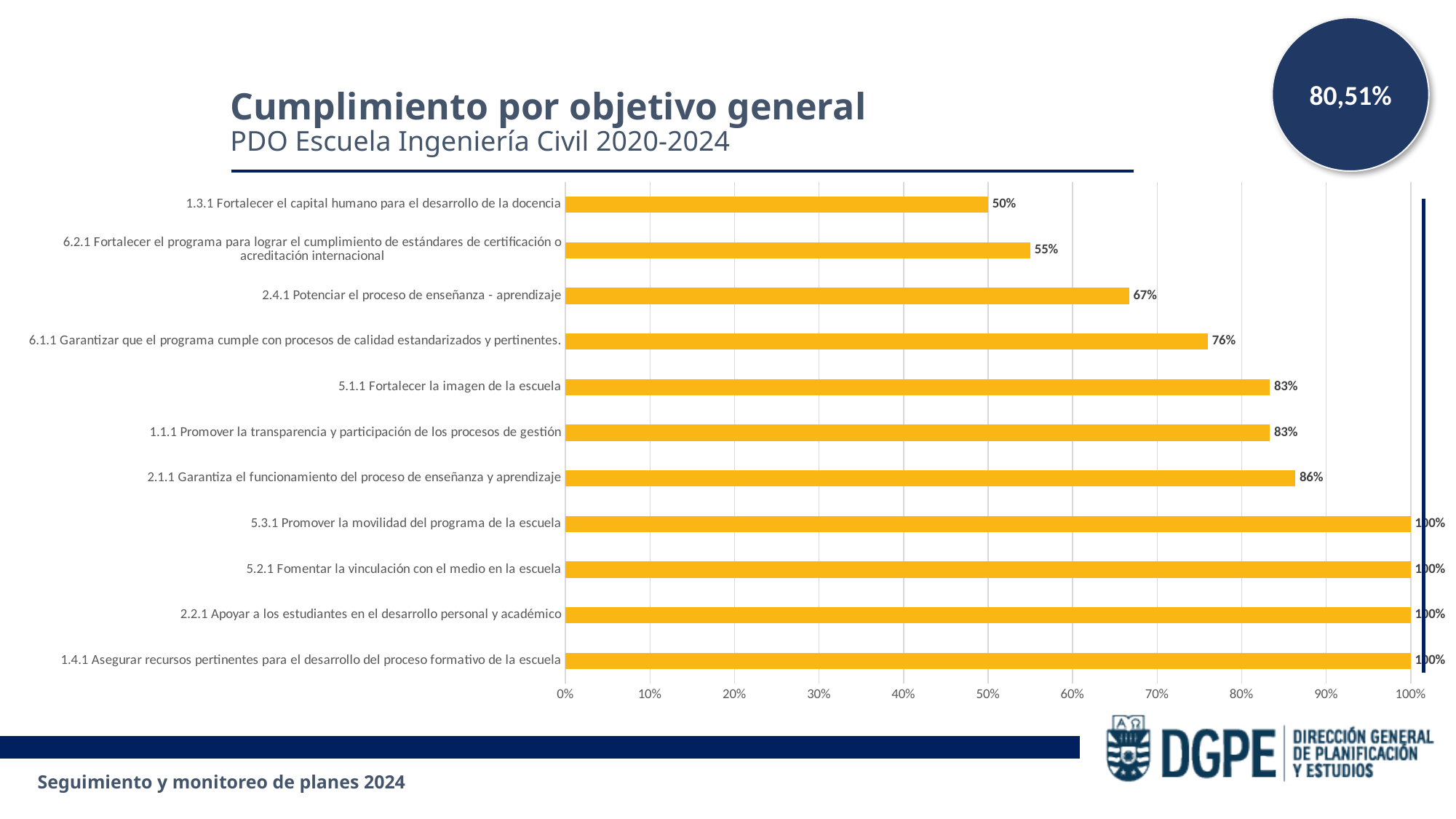
What is the value for 2.4.1 Potenciar el proceso de enseñanza - aprendizaje? 67% What is the value for 6.1.1 Garantizar que el programa cumple con procesos de calidad estandarizados y pertinentes? 76% Is the value for 6.1.1 Garantizar que el programa cumple con procesos de calidad estandarizados y pertinentes greater or less than 70%? greater What is the title of the chart? Cumplimiento por objetivo general How many categories are shown in the chart? 11 How many categories have a value of 100%? 4 What kind of chart is shown on the slide? Bar chart What is the difference between the values for 5.1.1 Fortalecer la imagen de la escuela and 1.3.1 Fortalecer el capital humano para el desarrollo de la docencia? 33% What is the value for 1.3.1 Fortalecer el capital humano para el desarrollo de la docencia? 50% Which category has the lowest value? 1.3.1 Fortalecer el capital humano para el desarrollo de la docencia What is the value for 2.1.1 Garantiza el funcionamiento del proceso de enseñanza y aprendizaje? 86% Which is larger: the value for 6.2.1 Fortalecer el programa para lograr el cumplimiento de estándares de certificación o acreditación internacional or the value for 2.4.1 Potenciar el proceso de enseñanza - aprendizaje? 2.4.1 Potenciar el proceso de enseñanza - aprendizaje